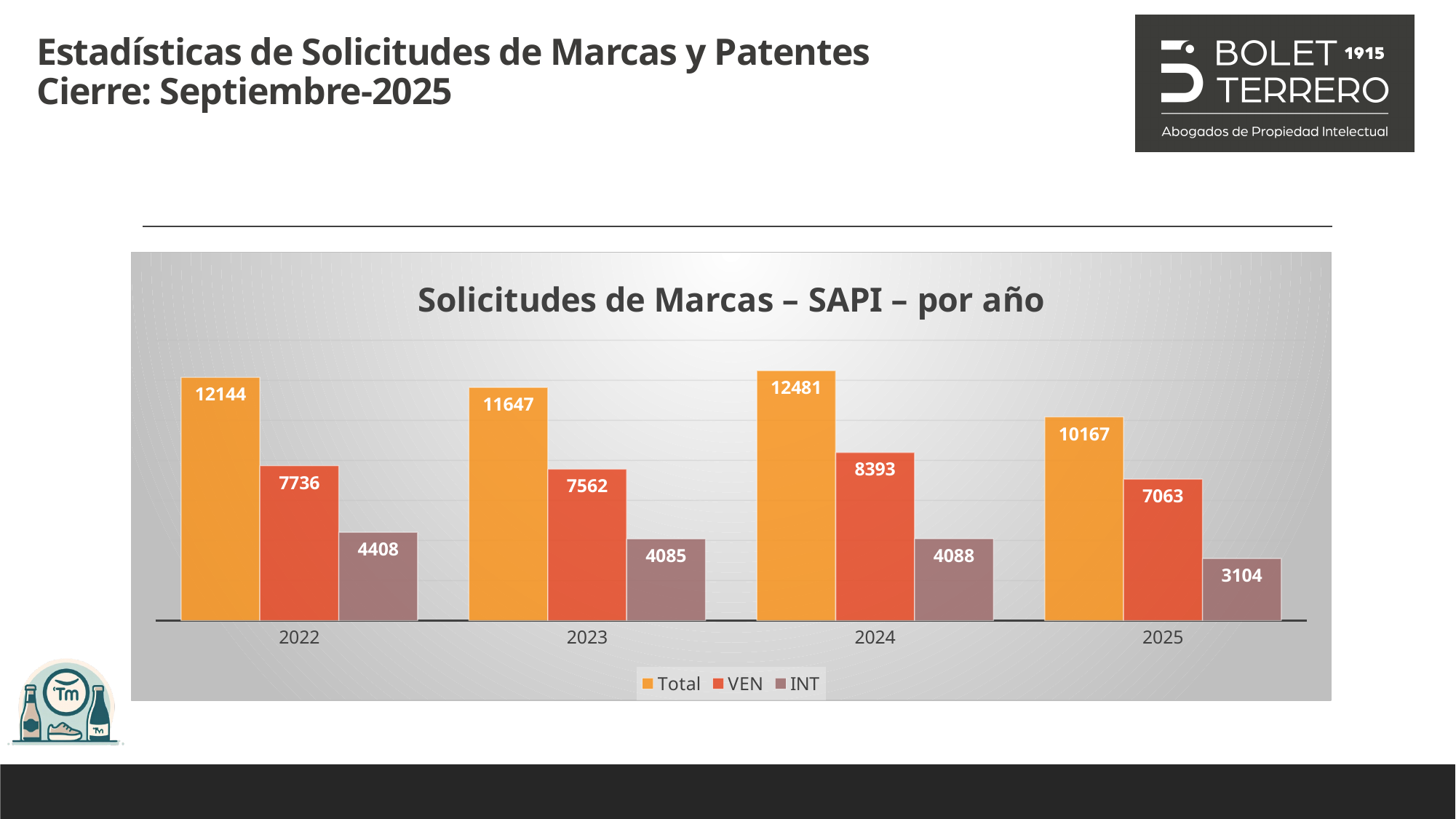
What is the title of the chart? Solicitudes de Marcas – SAPI – por año Which is larger, the VEN value for 2024 or the VEN value for 2023? VEN value for 2024 How many series does the legend list? 3 What kind of chart is shown on the slide? Bar chart Which year has the lowest INT value? 2025 What is the VEN value for 2022? 7736 Which year has the highest Total value? 2024 How many years are shown on the x axis? 4 What is the Total value for 2024? 12481 What is the difference between the Total values for 2024 and 2025? 2314 What is the difference between the VEN and INT values for 2023? 3477 What is the INT value for 2025? 3104